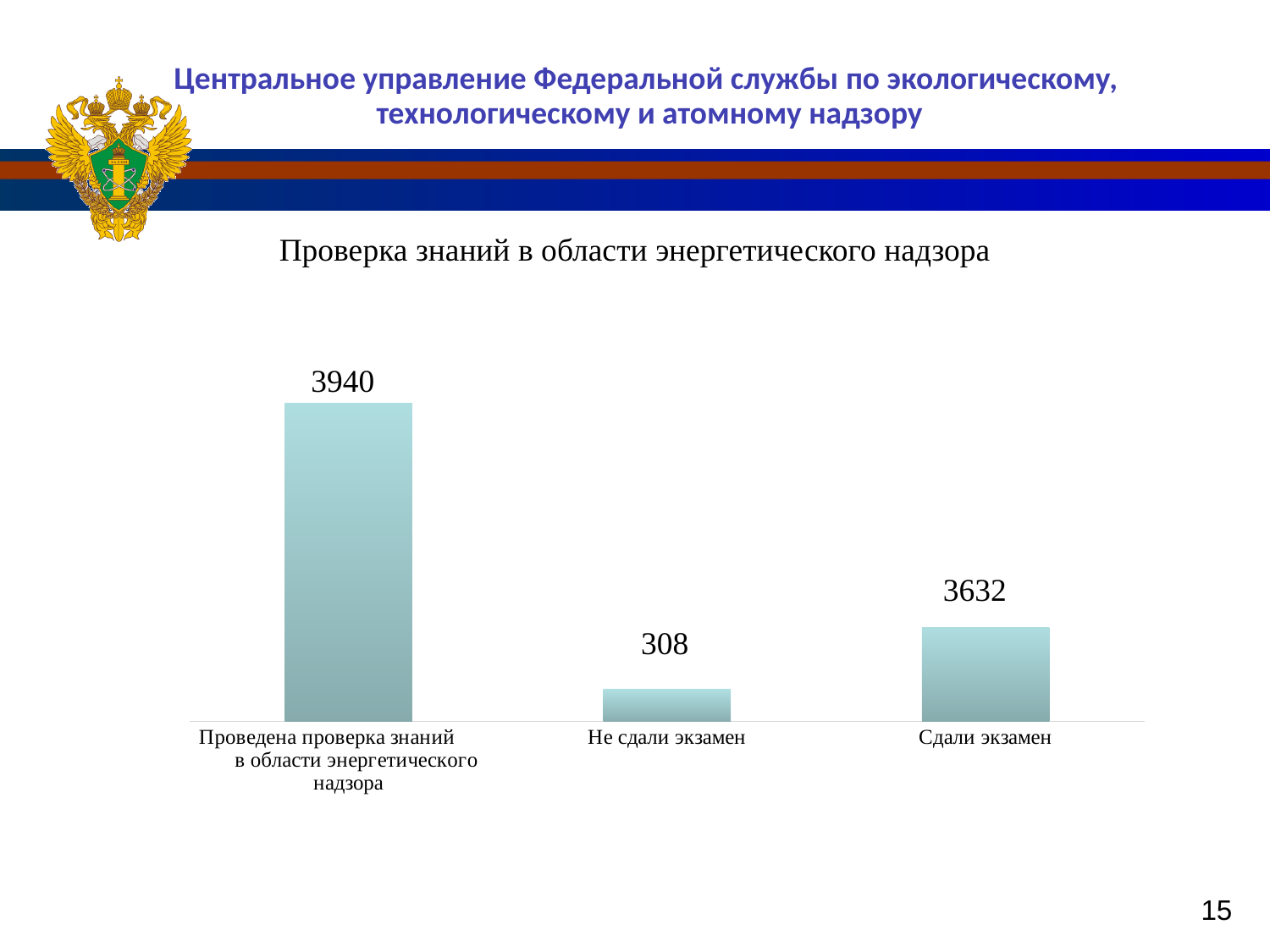
What is the difference between the values for "Проведена проверка знаний в области энергетического надзора" and "Сдали экзамен"? 308 What is the title of the chart? Проверка знаний в области энергетического надзора What is the value for "Не сдали экзамен"? 308 What kind of chart is shown on the slide? Bar chart Which is larger: the value for "Сдали экзамен" or the value for "Не сдали экзамен"? Сдали экзамен What is the value for "Проведена проверка знаний в области энергетического надзора"? 3940 Which category has the lowest value? Не сдали экзамен What is the sum of the values for "Не сдали экзамен" and "Сдали экзамен"? 3940 Which category has the highest value? Проведена проверка знаний в области энергетического надзора What is the value for "Сдали экзамен"? 3632 What is the difference between the values for "Сдали экзамен" and "Не сдали экзамен"? 3324 How many categories are shown in the chart? 3